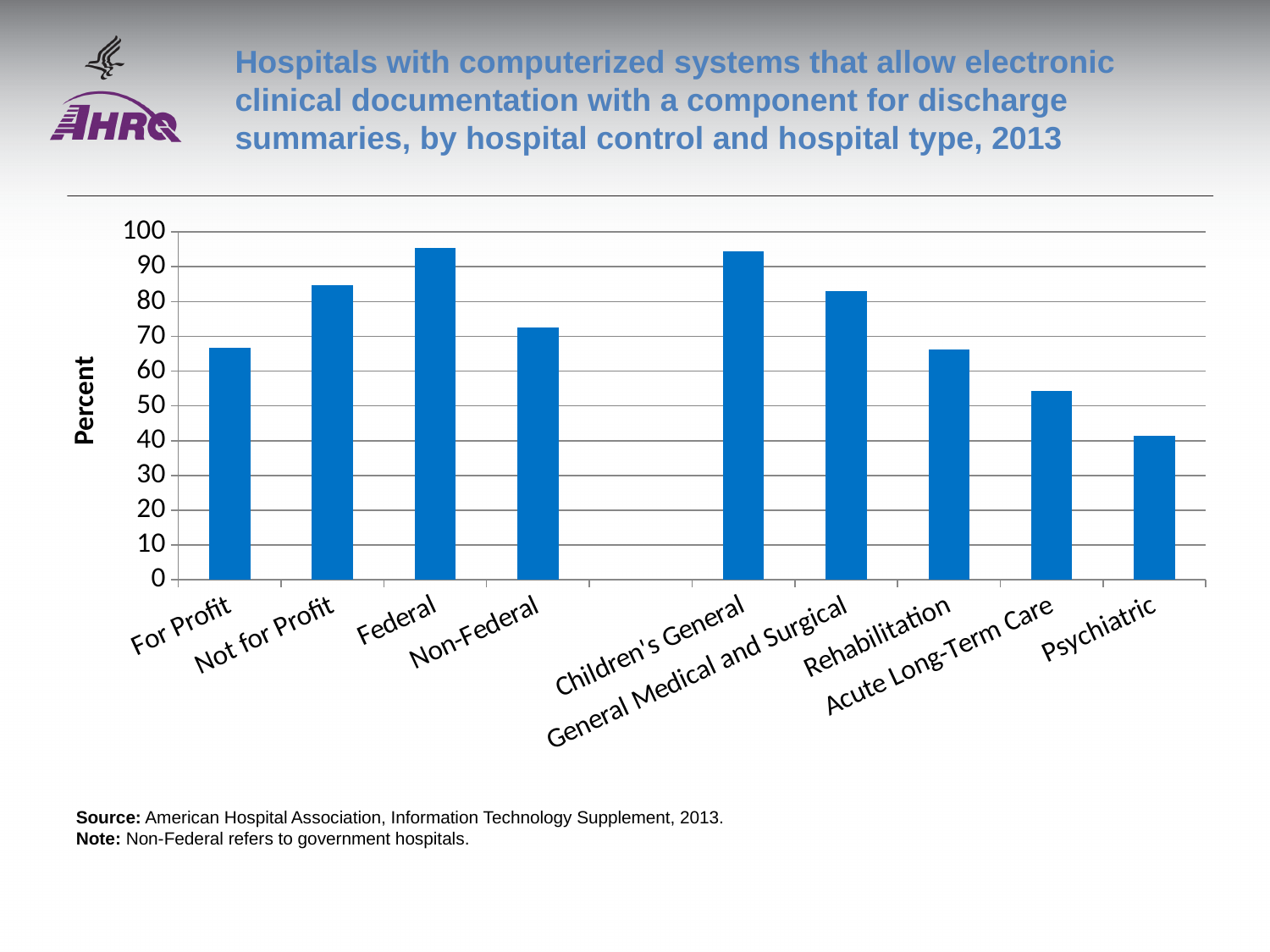
How many hospital categories are plotted in the chart? 9 Which is larger, the value for Rehabilitation or the value for General Medical and Surgical? General Medical and Surgical Is the value for For Profit greater or less than 60? greater What is the label of the vertical axis? Percent Which category has the lowest percentage in the chart? Psychiatric Which is larger, the value for Not for Profit or the value for For Profit? Not for Profit Is the value for Psychiatric greater or less than 50? less What kind of chart is shown on the slide? bar chart According to the note on the slide, what does Non-Federal refer to? government hospitals Is the value for Acute Long-Term Care greater or less than 60? less